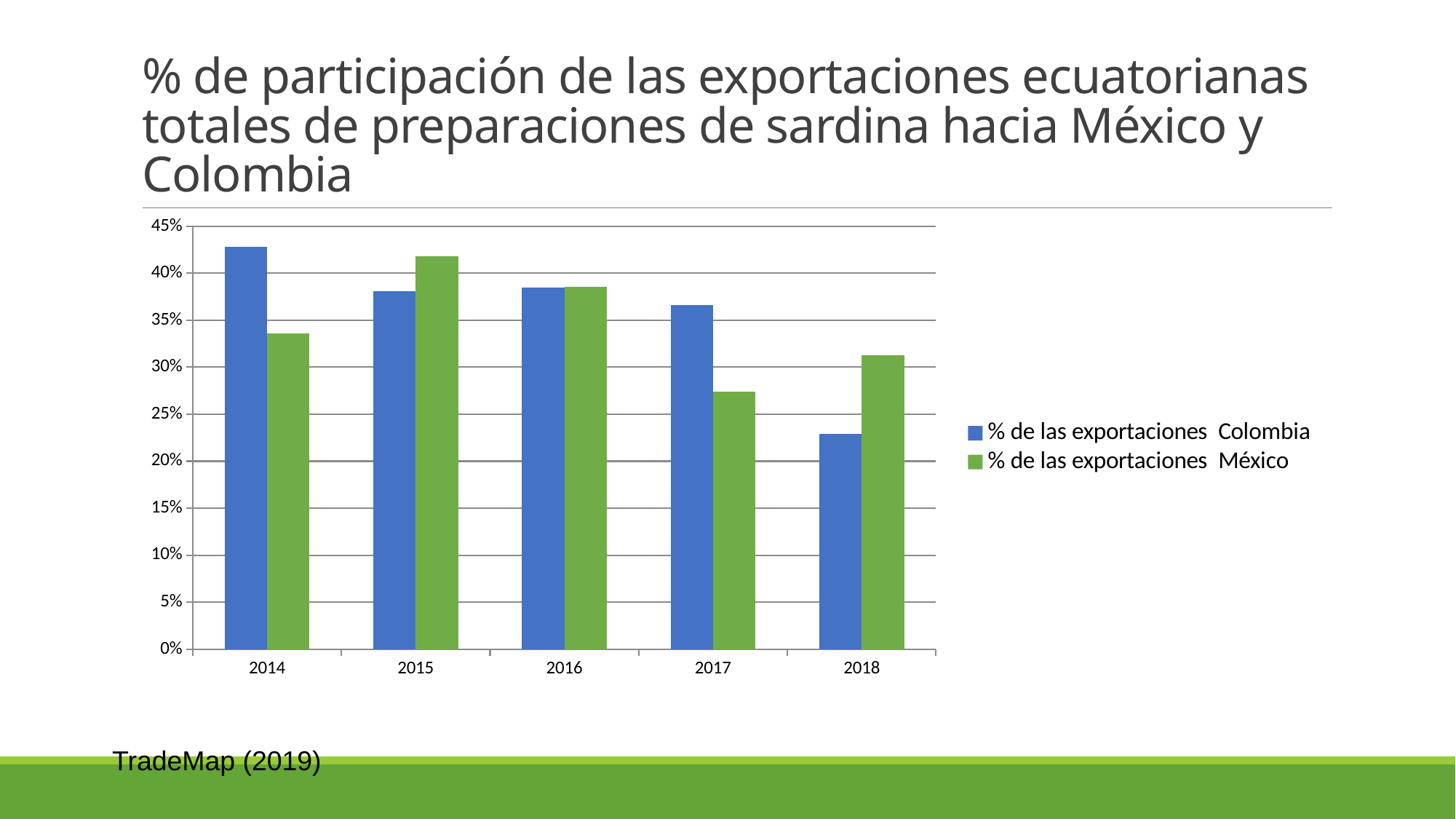
In which year is the value for % de las exportaciones México highest? 2015 In 2014, which series has the larger value, Colombia or México? Colombia What kind of chart is shown on the slide? bar chart How many years are shown on the x axis? 5 In which year is the value for % de las exportaciones Colombia highest? 2014 In 2018, which series has the larger value, Colombia or México? México In which year is the value for % de las exportaciones Colombia lowest? 2018 How many series does the legend list? 2 Is the value for % de las exportaciones Colombia in 2018 greater or less than 25%? less In which year is the value for % de las exportaciones México lowest? 2017 Is the value for % de las exportaciones México in 2014 greater or less than 30%? greater Overall, does the % de las exportaciones Colombia series rise or fall from 2014 to 2018? fall